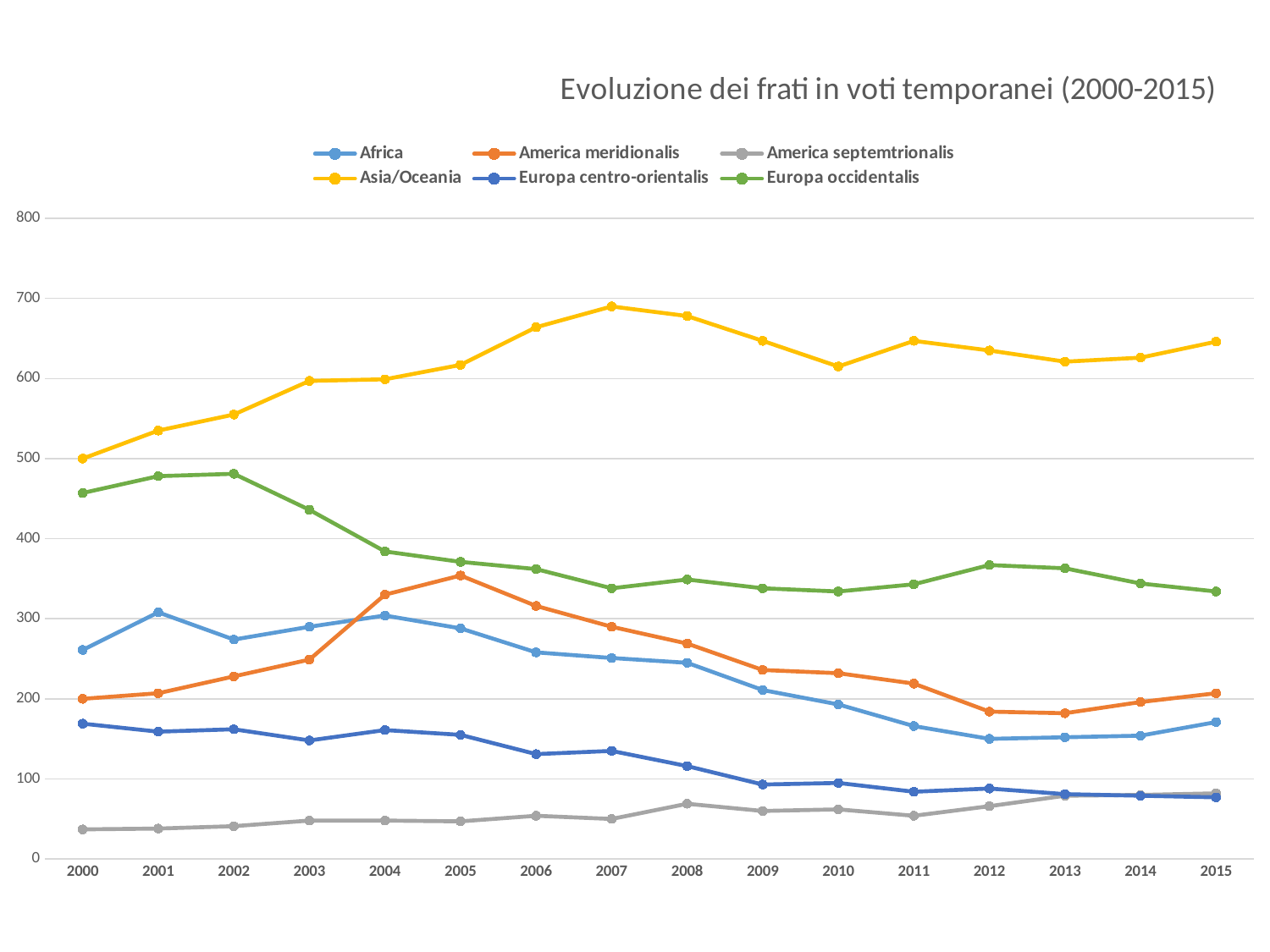
Is the value for Europa occidentalis in 2000 greater or less than 500? less Is the value for Asia/Oceania in 2007 greater or less than 650? greater In which year does the Asia/Oceania series reach its highest value? 2007 In 2000, which is larger: the value for Africa or the value for America meridionalis? Africa What kind of chart is shown on the slide? line chart What is the title of the chart? Evoluzione dei frati in voti temporanei (2000-2015) Does the Europa occidentalis series rise or fall overall from 2000 to 2015? fall How many series does the legend list? 6 How many years are shown along the x axis? 16 Is the value for America meridionalis in 2005 greater or less than 300? greater Which series has the lowest value in 2000? America septemtrionalis Which series has the highest value in 2015? Asia/Oceania